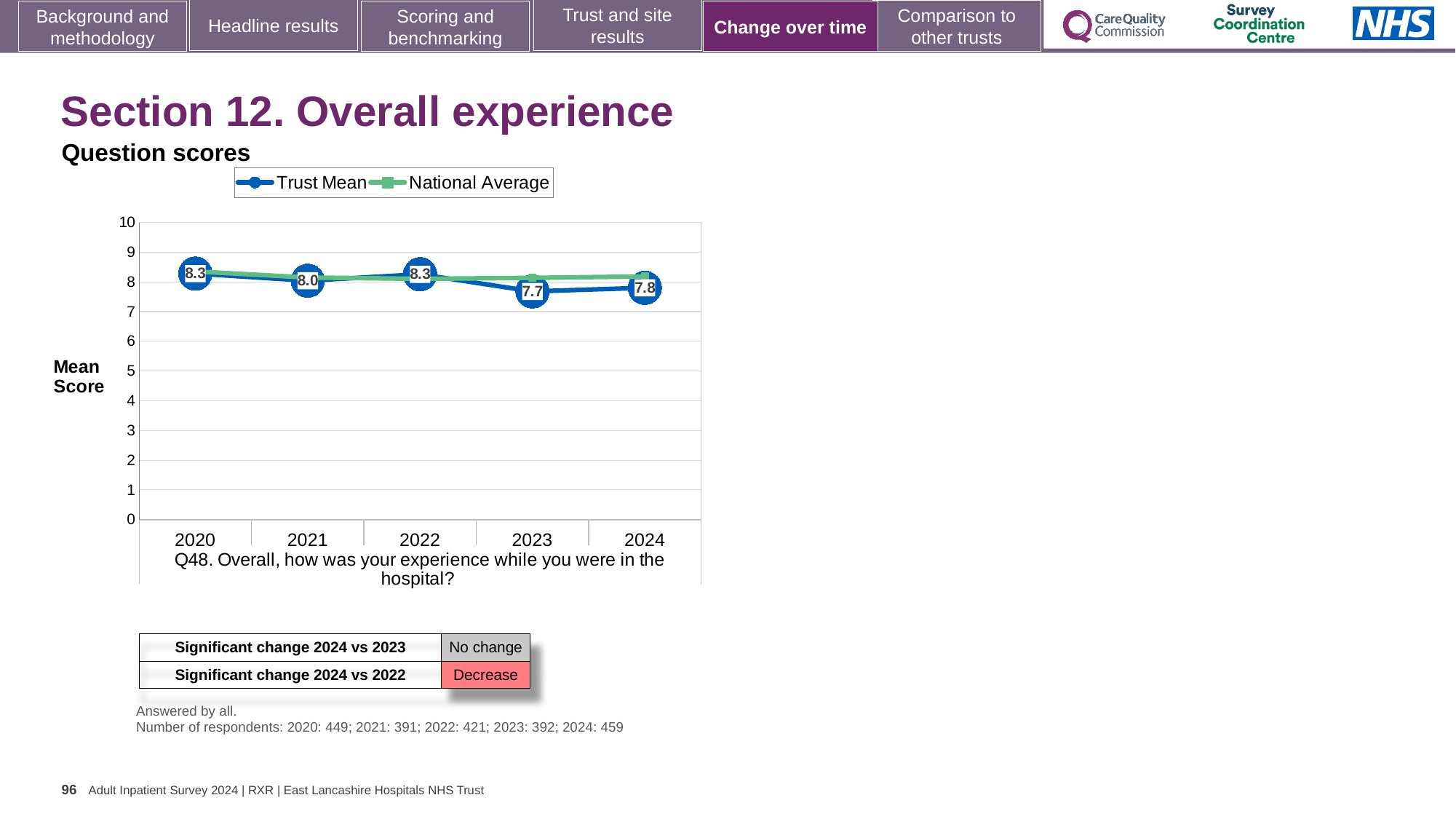
Does the Trust Mean score rise or fall from 2020 to 2024? Fall In which year is the Trust Mean score lowest? 2023 What is the difference between the Trust Mean scores for 2022 and 2023? 0.6 What is the Trust Mean score for 2023? 7.7 What kind of chart is shown on the slide? Line chart Is the National Average value for 2024 greater or less than 7? greater How many years are plotted on the x axis? 5 Which year has the higher Trust Mean score, 2021 or 2024? 2021 What is the Trust Mean score for 2020? 8.3 What is the Trust Mean score for 2024? 7.8 What are the two series named in the legend? Trust Mean and National Average How many series does the legend list? 2